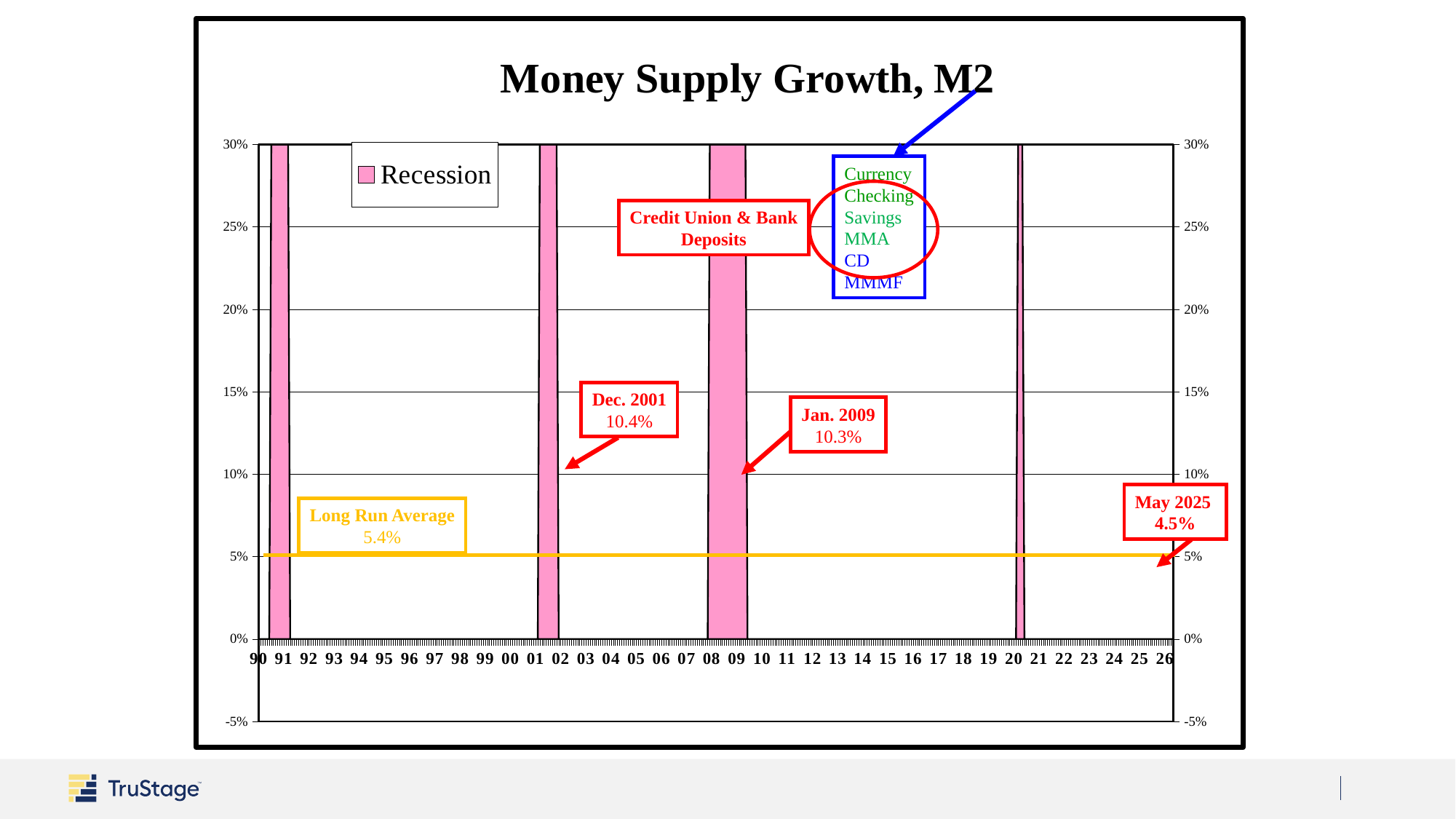
Is the annotated Jan. 2009 value greater or less than 10%? greater Which annotated value is larger, Dec. 2001 or Jan. 2009? Dec. 2001 What is the Long Run Average value shown on the chart? 5.4% Is the annotated May 2025 value greater or less than the Long Run Average of 5.4%? less How many entries does the legend list? 1 What M2 growth value is annotated for Jan. 2009? 10.3% What M2 growth value is annotated for Dec. 2001? 10.4% What is the title of the chart? Money Supply Growth, M2 What is the difference between the annotated Dec. 2001 value and the annotated May 2025 value? 5.9% How many shaded recession periods are shown on the chart? 4 What is the highest value shown on the vertical axis? 30% What M2 growth value is annotated for May 2025? 4.5%